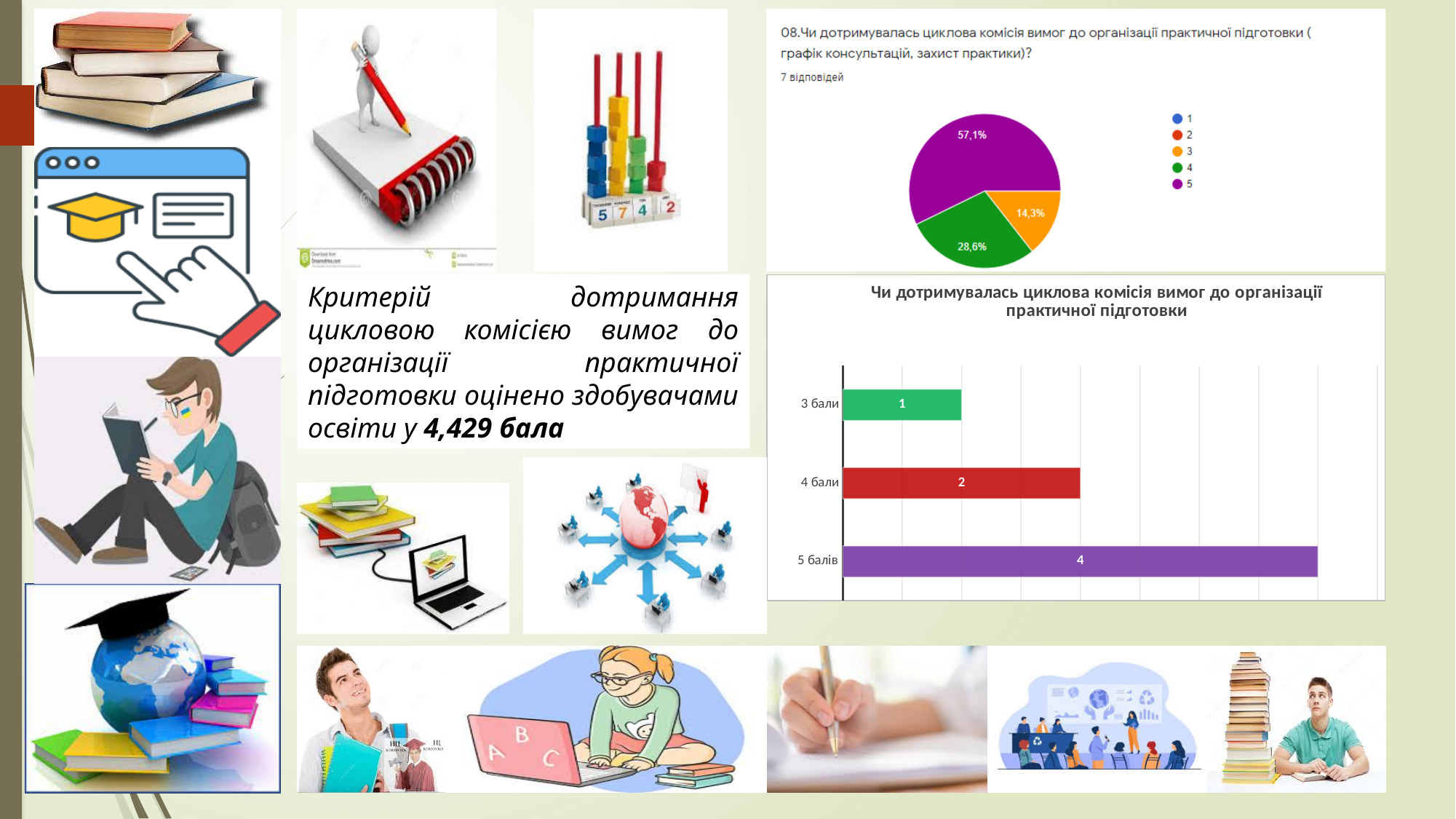
In the pie chart at the top right, what percentage is shown for the orange slice (rating 3)? 14,3% In the bar chart at the bottom right, how many categories are plotted? 3 In the bar chart at the bottom right, which category has the lowest value? 3 бали In the pie chart at the top right, what share of responses is shown for the purple slice (rating 5)? 57,1% In the pie chart at the top right, how many entries does the legend list? 5 In the pie chart at the top right, which rating has the largest slice? 5 What kind of chart is the chart at the bottom right titled 'Чи дотримувалась циклова комісія вимог до організації практичної підготовки'? bar chart In the bar chart at the bottom right, what is the difference between the values for '5 балів' and '3 бали'? 3 In the pie chart at the top right, how many responses (відповідей) are reported under the question? 7 In the bar chart at the bottom right, what is the value for '4 бали'? 2 In the bar chart at the bottom right, what is the value for '5 балів'? 4 In the pie chart at the top right, what percentage is shown for the green slice (rating 4)? 28,6%